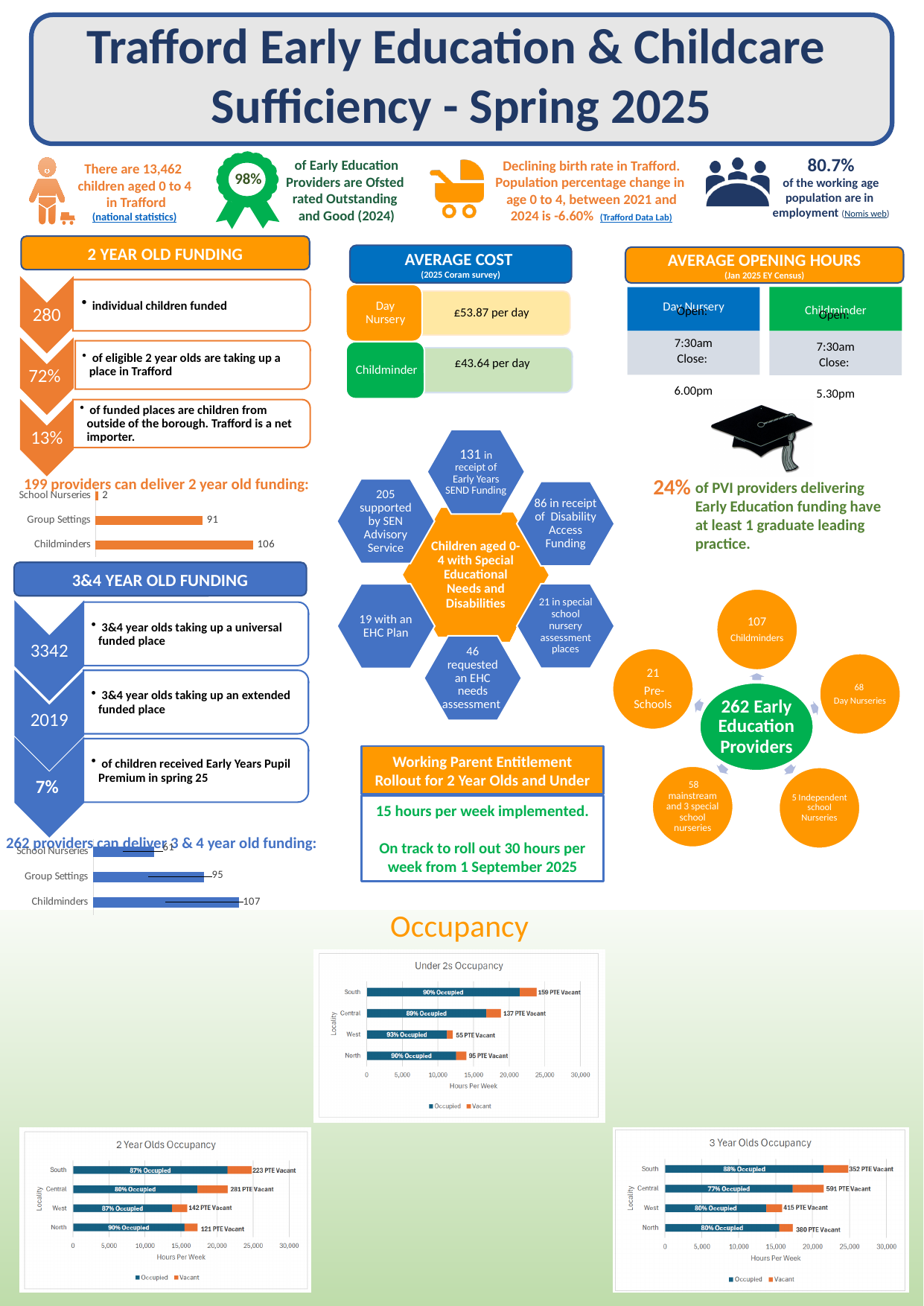
In the '199 providers can deliver 2 year old funding' chart, which category has the lowest value? School Nurseries In the 'Under 2s Occupancy' chart, what is the occupied percentage for West? 93% Occupied In the '199 providers can deliver 2 year old funding' chart, how many Childminders are shown? 106 In the '199 providers can deliver 2 year old funding' chart, what is the difference between Childminders and Group Settings? 15 In the '2 Year Olds Occupancy' chart, which locality has the lowest occupied percentage? Central In the '262 providers can deliver 3 & 4 year old funding' chart, which category has the highest value? Childminders In the '262 providers can deliver 3 & 4 year old funding' chart, what is the value for School Nurseries? 61 What type of chart is the '199 providers can deliver 2 year old funding' chart? Bar chart In the '262 providers can deliver 3 & 4 year old funding' chart, how many categories are shown? 3 How many series does the legend of the '3 Year Olds Occupancy' chart list? 2 In the '3 Year Olds Occupancy' chart, how many PTE vacant are shown for Central? 591 PTE Vacant In the 'Under 2s Occupancy' chart, how many PTE vacant are shown for Central? 137 PTE Vacant